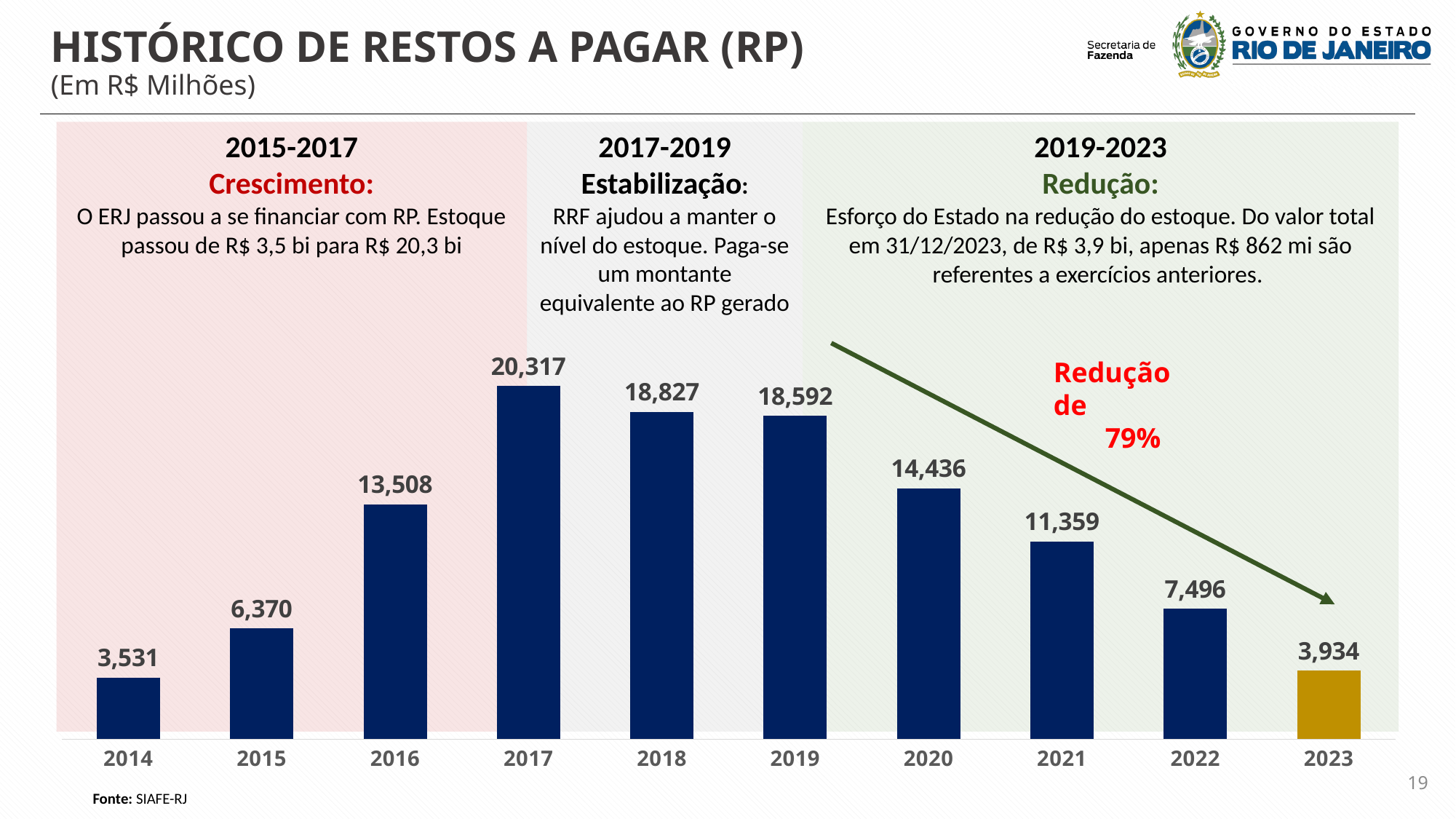
What is the value for 2023? 3,934 What is the value for 2020? 14,436 Which year has the lowest value? 2014 Which is larger, the value for 2018 or the value for 2019? 2018 Which bar is coloured differently from the others? 2023 Which year has the highest value? 2017 What is the difference between the values for 2017 and 2023? 16,383 What kind of chart is shown on the slide? bar chart What is the value for 2017? 20,317 What is the difference between the values for 2021 and 2022? 3,863 How many years are shown on the x axis? 10 Do the values rise or fall from 2019 to 2023? fall